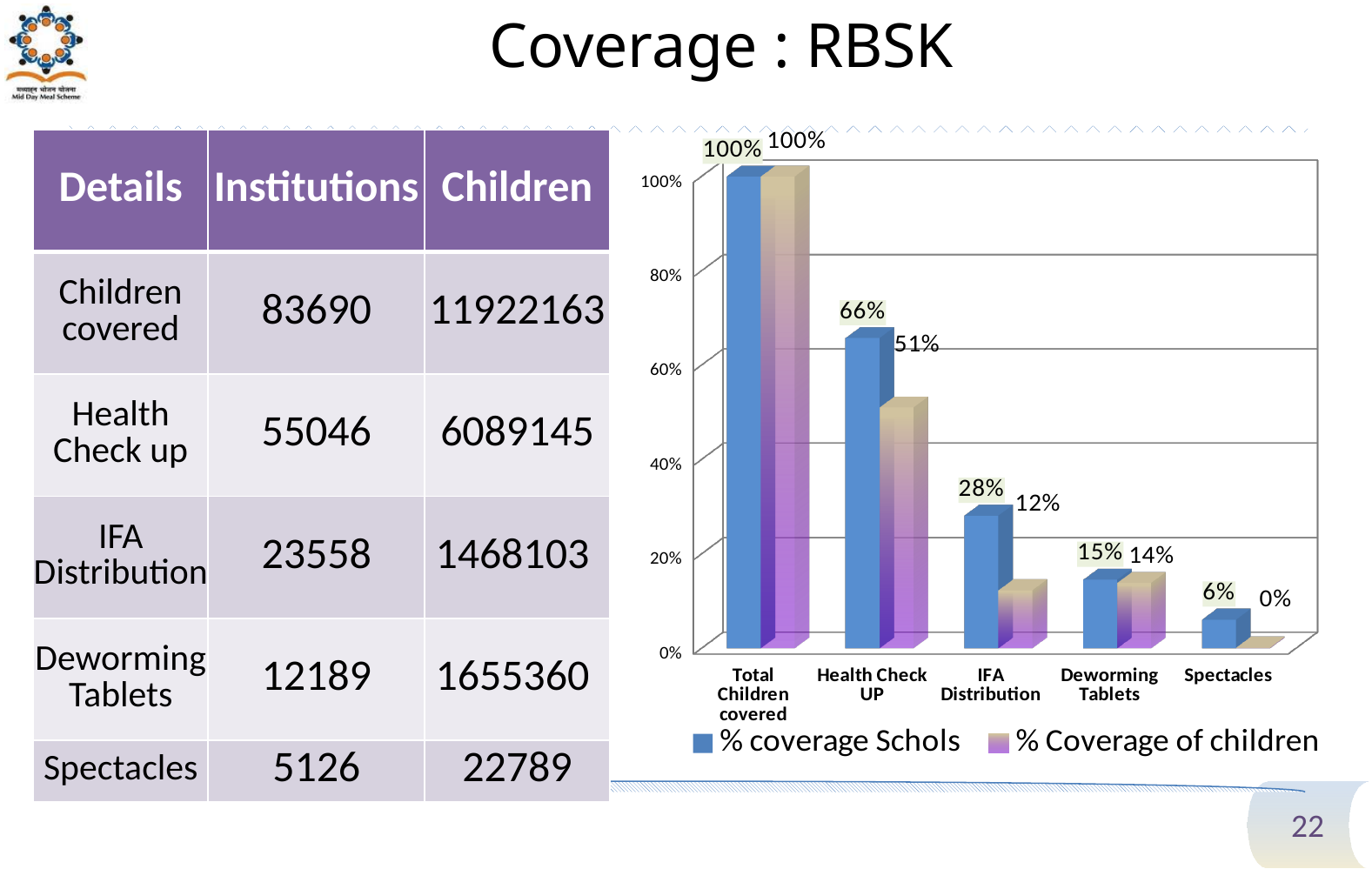
What is the difference between the % coverage Schols and % Coverage of children values for Health Check UP? 15% What is the % Coverage of children value for Spectacles? 0% What is the % Coverage of children value for IFA Distribution? 12% Which category has the highest % Coverage of children value? Total Children covered How many categories are shown on the chart's x axis? 5 Which is larger for IFA Distribution: % coverage Schols or % Coverage of children? % coverage Schols What type of chart is shown on the slide? bar chart Do the % coverage Schols values rise or fall from left to right along the x axis? fall Which series is shown in blue in the chart legend? % coverage Schols What is the % coverage Schols value for Health Check UP? 66% How many series does the chart legend list? 2 Which category has the lowest % coverage Schols value? Spectacles